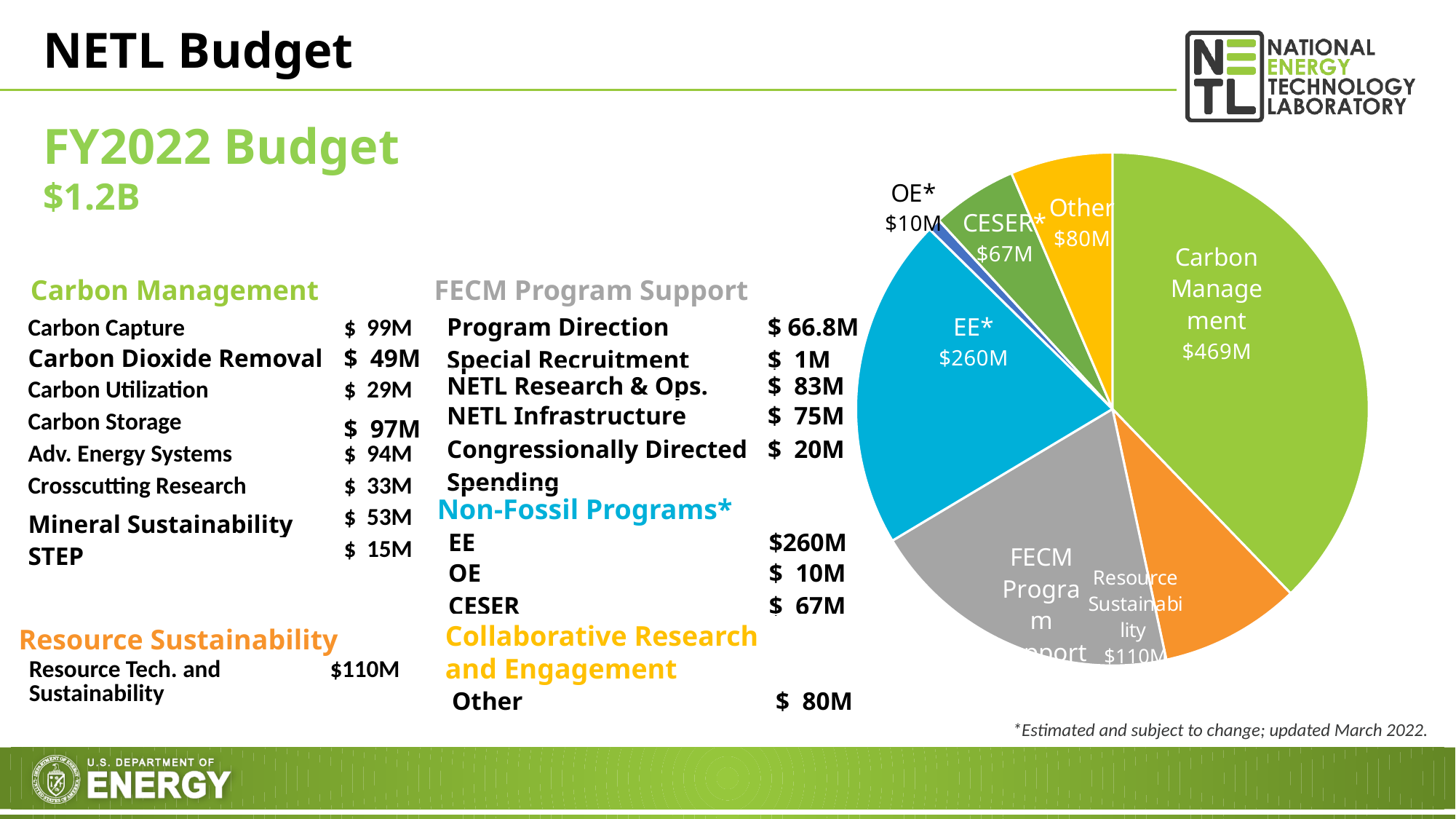
Which slice of the pie chart is the smallest? OE* What is the value of the EE* slice in the pie chart? $260M What is the difference between the Carbon Management slice and the EE* slice in the pie chart? $209M Which is larger in the pie chart, the Other slice or the CESER* slice? Other What type of chart is shown on the slide? Pie chart What is the value of the CESER* slice in the pie chart? $67M Which slice of the pie chart is the largest? Carbon Management What colour is the EE* slice in the pie chart? Blue What is the value of the Other slice in the pie chart? $80M What is the value of the OE* slice in the pie chart? $10M What is the value of the Carbon Management slice in the pie chart? $469M How many slices does the pie chart have? 7